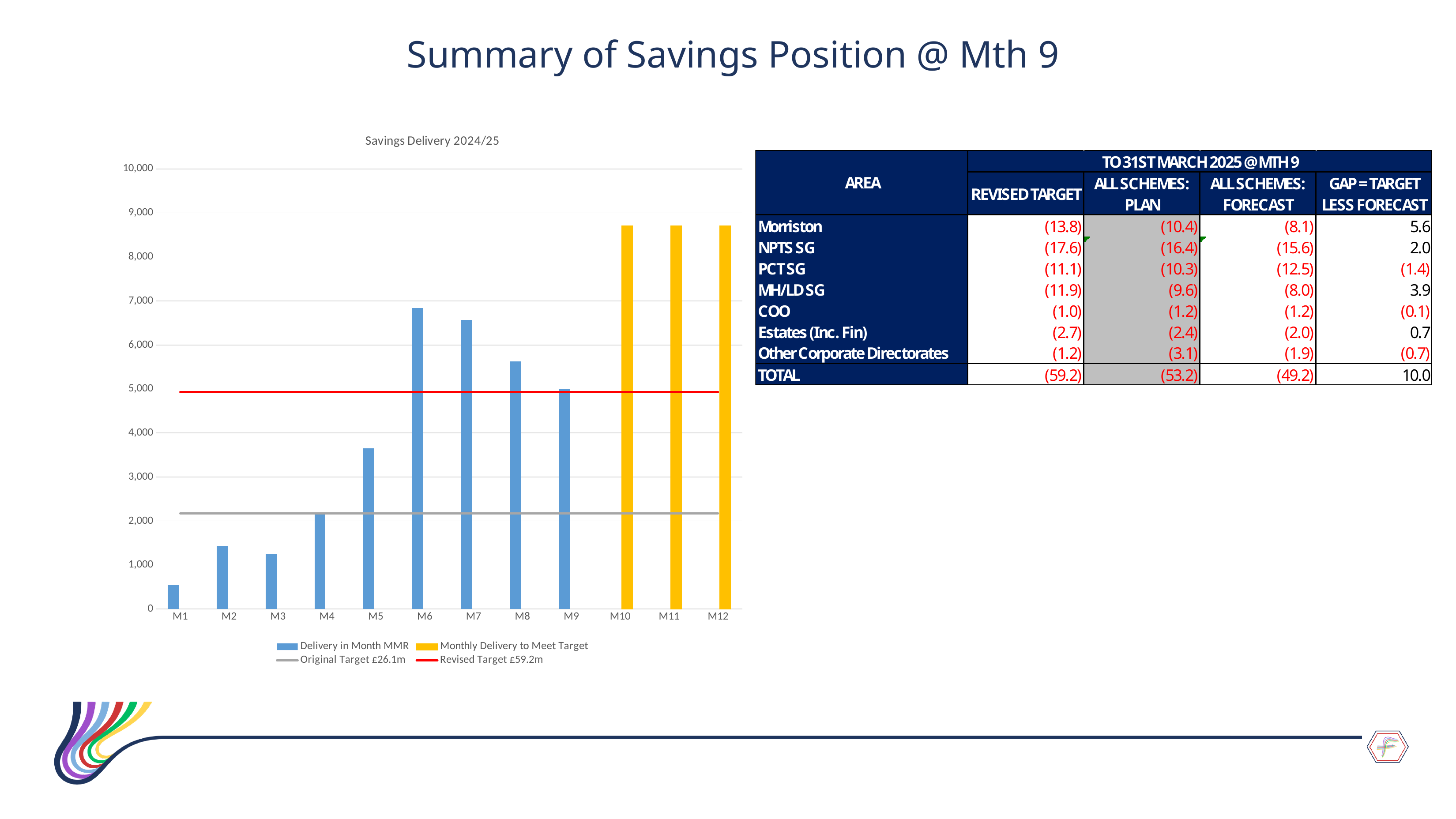
Which bar is taller, M6 or M8? M6 What kind of chart is the "Savings Delivery 2024/25" chart? Combination bar and line chart Is the value for M3 greater or less than 2,000? less How many months are shown on the x axis of the "Savings Delivery 2024/25" chart? 12 Which month has the tallest blue "Delivery in Month MMR" bar? M6 What does the legend call the yellow bars in the "Savings Delivery 2024/25" chart? Monthly Delivery to Meet Target Which month has the shortest bar in the "Savings Delivery 2024/25" chart? M1 How many entries does the legend of the "Savings Delivery 2024/25" chart list? 4 What value does the legend give for the Revised Target line? £59.2m Is the value for M5 greater or less than 3,000? greater Do the blue bars rise or fall from M1 to M6? rise Is the value for M10 greater or less than 8,000? greater